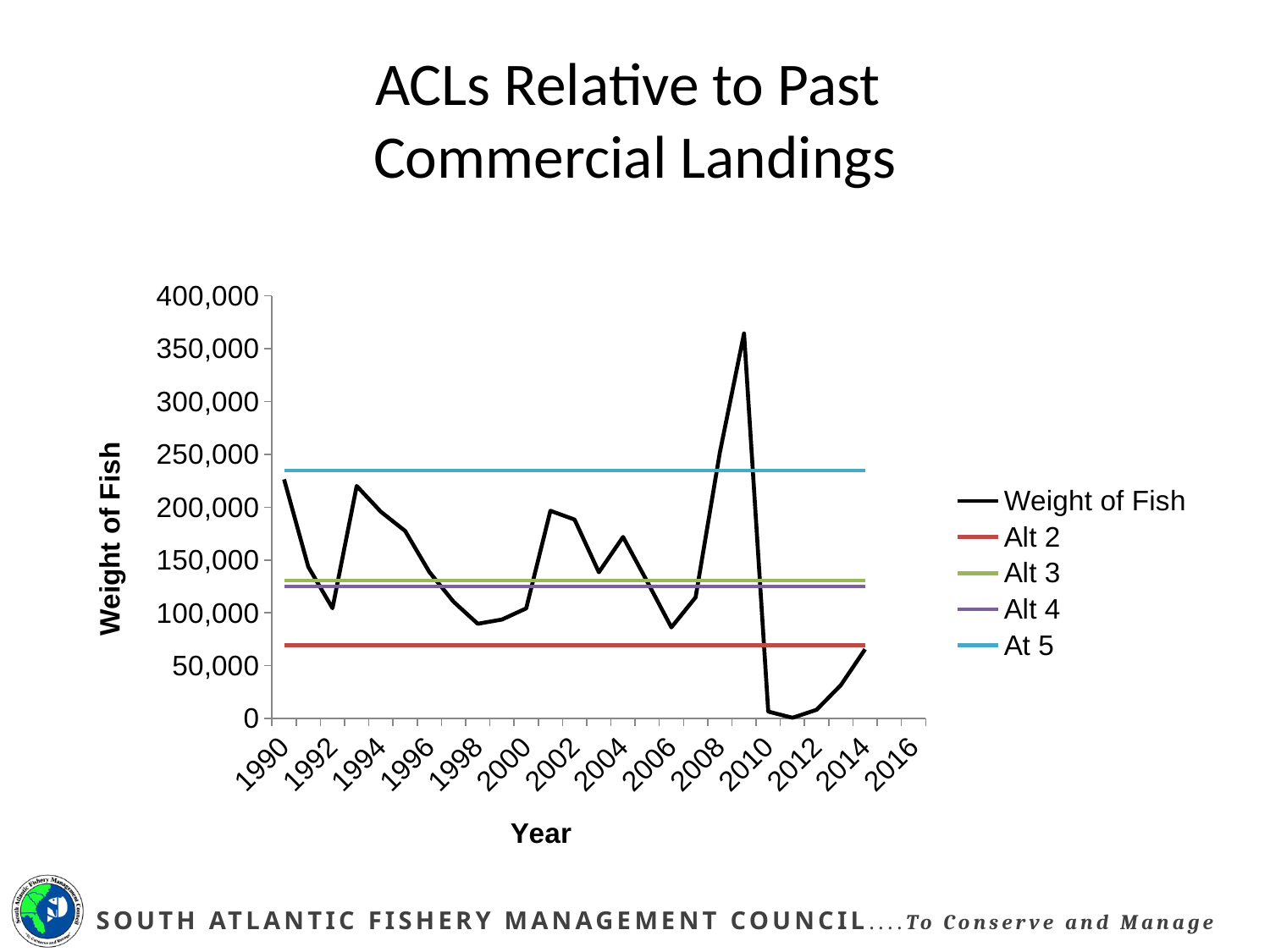
Does the Weight of Fish series rise or fall between 2009 and 2011? fall How many series does the legend list? 5 In which year does the Weight of Fish series reach its highest value? 2009 Is the peak value of the Weight of Fish series greater or less than 300,000? greater What is the label on the y axis? Weight of Fish Which of the horizontal ACL lines (Alt 2, Alt 3, Alt 4, At 5) is the highest? At 5 Which is larger, the Weight of Fish in 1990 or in 1992? 1990 Which of the horizontal ACL lines (Alt 2, Alt 3, Alt 4, At 5) is the lowest? Alt 2 What is the title of the chart? ACLs Relative to Past Commercial Landings What kind of chart is shown on the slide? line chart Is the value of the At 5 line greater or less than 200,000? greater Is the value of the Alt 2 line greater or less than 100,000? less